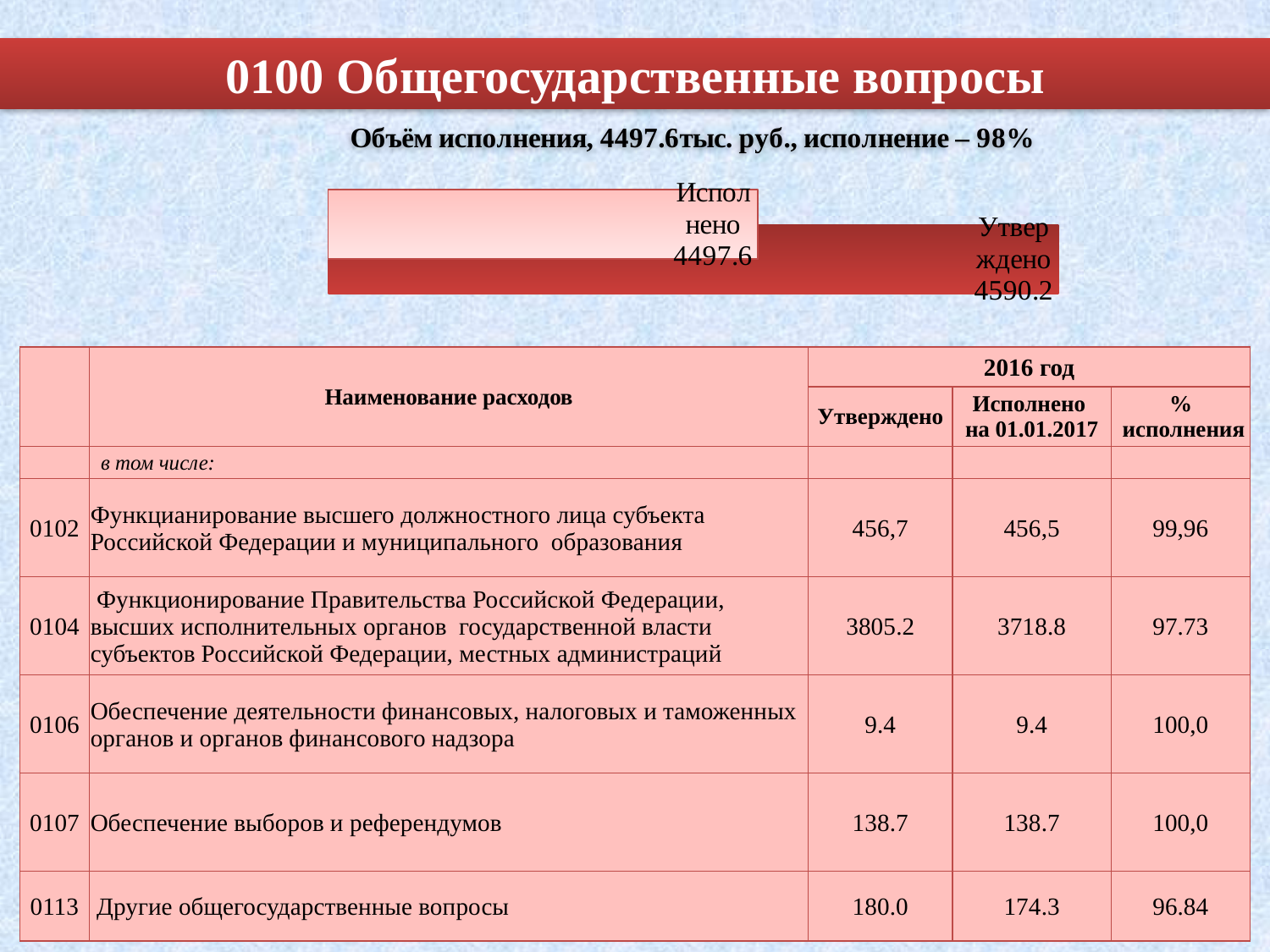
What is the difference between the Утверждено value and the Исполнено value? 92.6 What is the value of the bar labelled Утверждено? 4590.2 How many bars are plotted in the chart? 2 Which bar has the higher value, Исполнено or Утверждено? Утверждено Are the bars in the chart oriented horizontally or vertically? horizontally Which bar in the chart has the smallest value? Исполнено Which bar in the chart has the largest value? Утверждено What is the value of the bar labelled Исполнено? 4497.6 Is the value for Исполнено greater or less than 4500? less What type of chart is shown on the slide? bar chart Is the value for Утверждено greater or less than 4500? greater What is the title shown above the chart on the slide? 0100 Общегосударственные вопросы